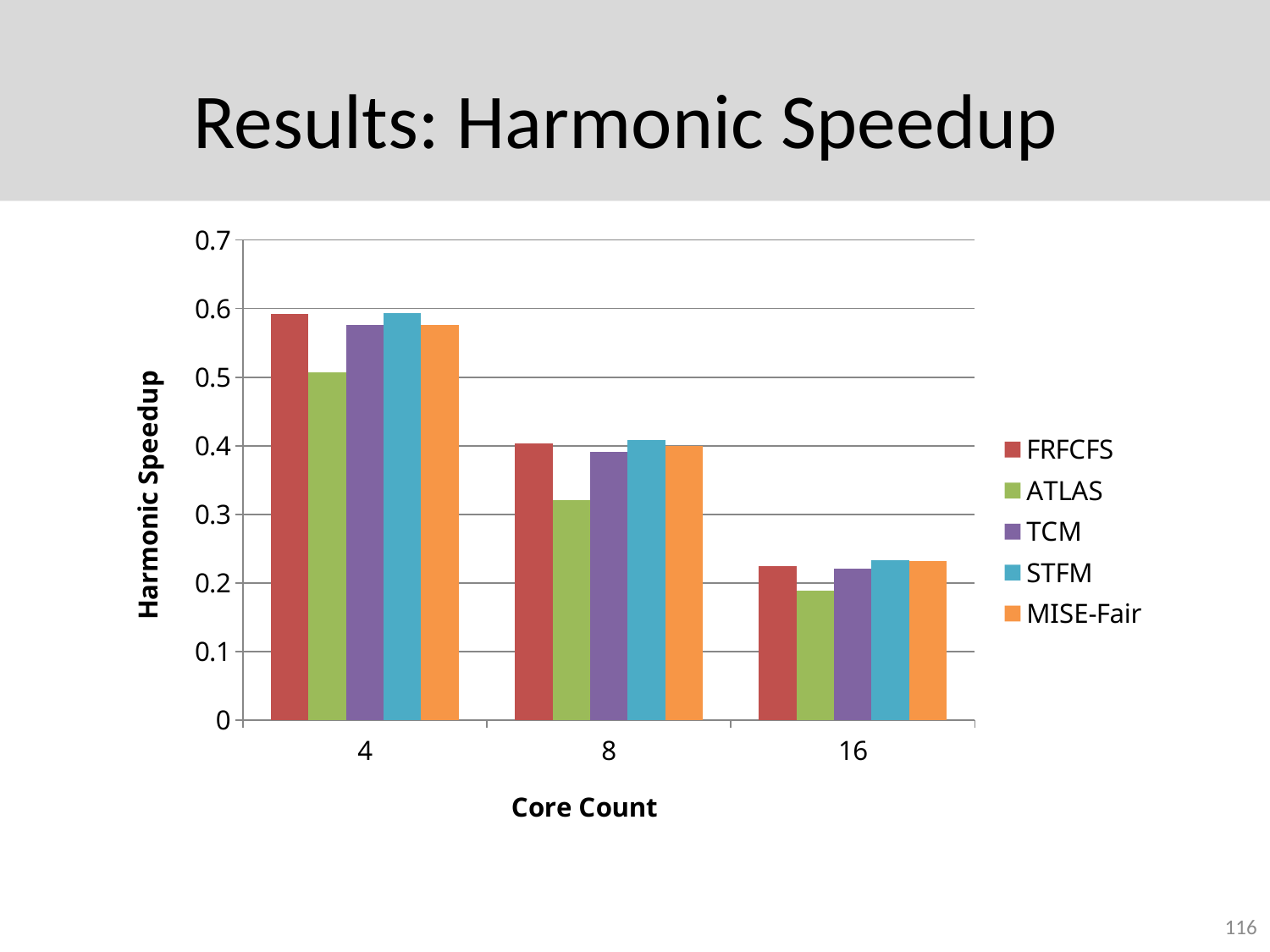
How many core count categories are shown on the x axis? 3 Which series has the lowest harmonic speedup at a core count of 16? ATLAS How many series does the legend list? 5 Is the harmonic speedup for FRFCFS at a core count of 4 greater or less than 0.5? greater What kind of chart is shown on the slide? bar chart Which series has the lowest harmonic speedup at a core count of 4? ATLAS Does the harmonic speedup for STFM rise or fall as the core count increases from 4 to 16? fall Is the harmonic speedup for MISE-Fair at a core count of 4 greater or less than 0.6? less What is the label of the y axis? Harmonic Speedup Is the harmonic speedup for ATLAS at a core count of 8 greater or less than 0.4? less At a core count of 8, which is larger: the harmonic speedup for FRFCFS or for ATLAS? FRFCFS